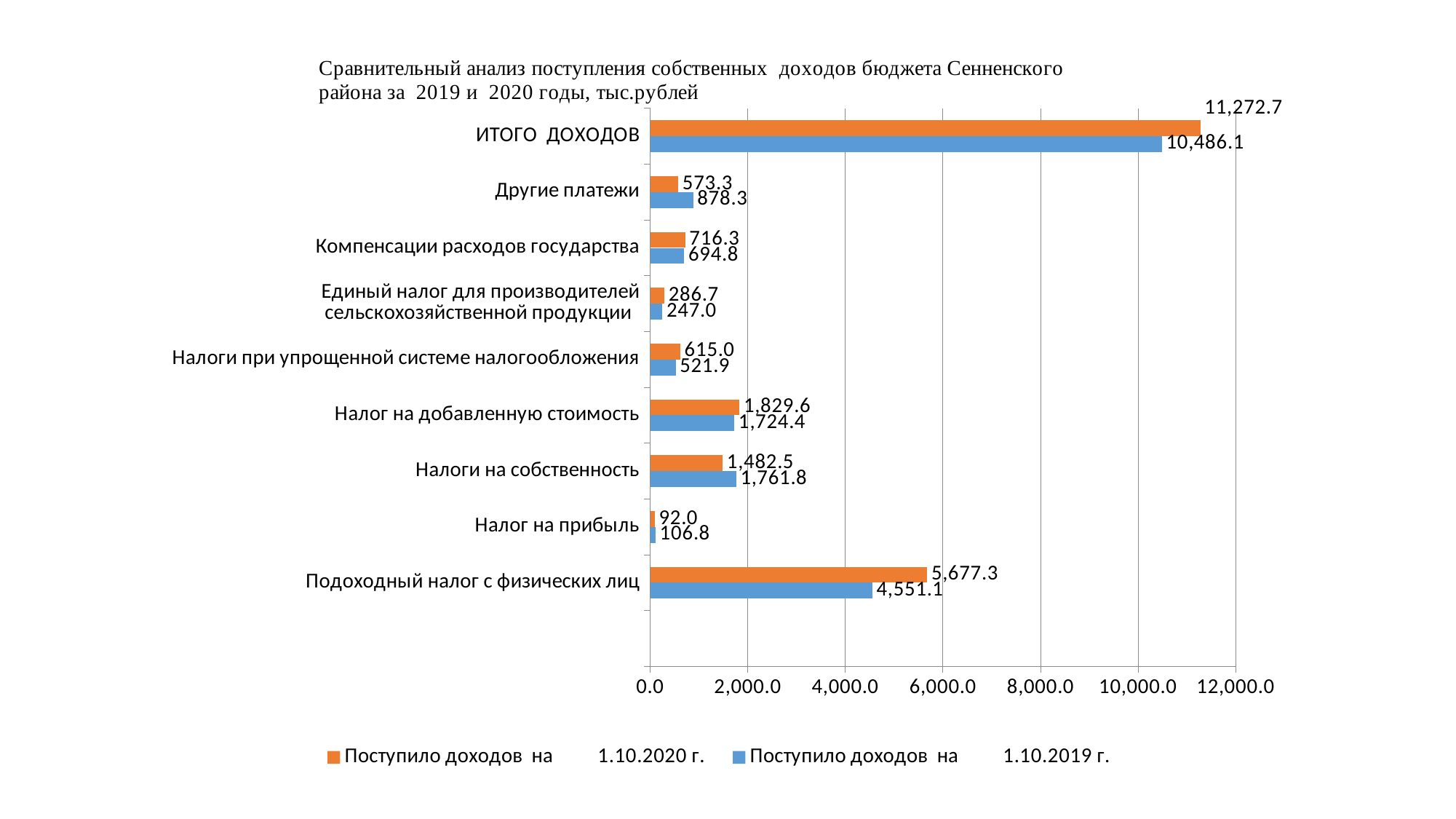
Excluding ИТОГО ДОХОДОВ, which category has the lowest value in the series Поступило доходов на 1.10.2020 г.? Налог на прибыль What is the difference between the 2020 and 2019 values for ИТОГО ДОХОДОВ? 786.6 What is the difference between the 2019 and 2020 values for Налоги на собственность? 279.3 Excluding ИТОГО ДОХОДОВ, which category has the highest value in the series Поступило доходов на 1.10.2019 г.? Подоходный налог с физических лиц How many categories are shown on the vertical axis of the chart? 9 What is the value for Подоходный налог с физических лиц in the series Поступило доходов на 1.10.2020 г.? 5,677.3 What kind of chart is shown on the slide? Bar chart For Другие платежи, which is larger: the value for 1.10.2020 г. or the value for 1.10.2019 г.? 1.10.2019 г. What is the value for ИТОГО ДОХОДОВ in the series Поступило доходов на 1.10.2019 г.? 10,486.1 What is the value for Налог на прибыль in the series Поступило доходов на 1.10.2020 г.? 92.0 How many series does the legend list? 2 What is the value for Налоги на собственность in the series Поступило доходов на 1.10.2019 г.? 1,761.8